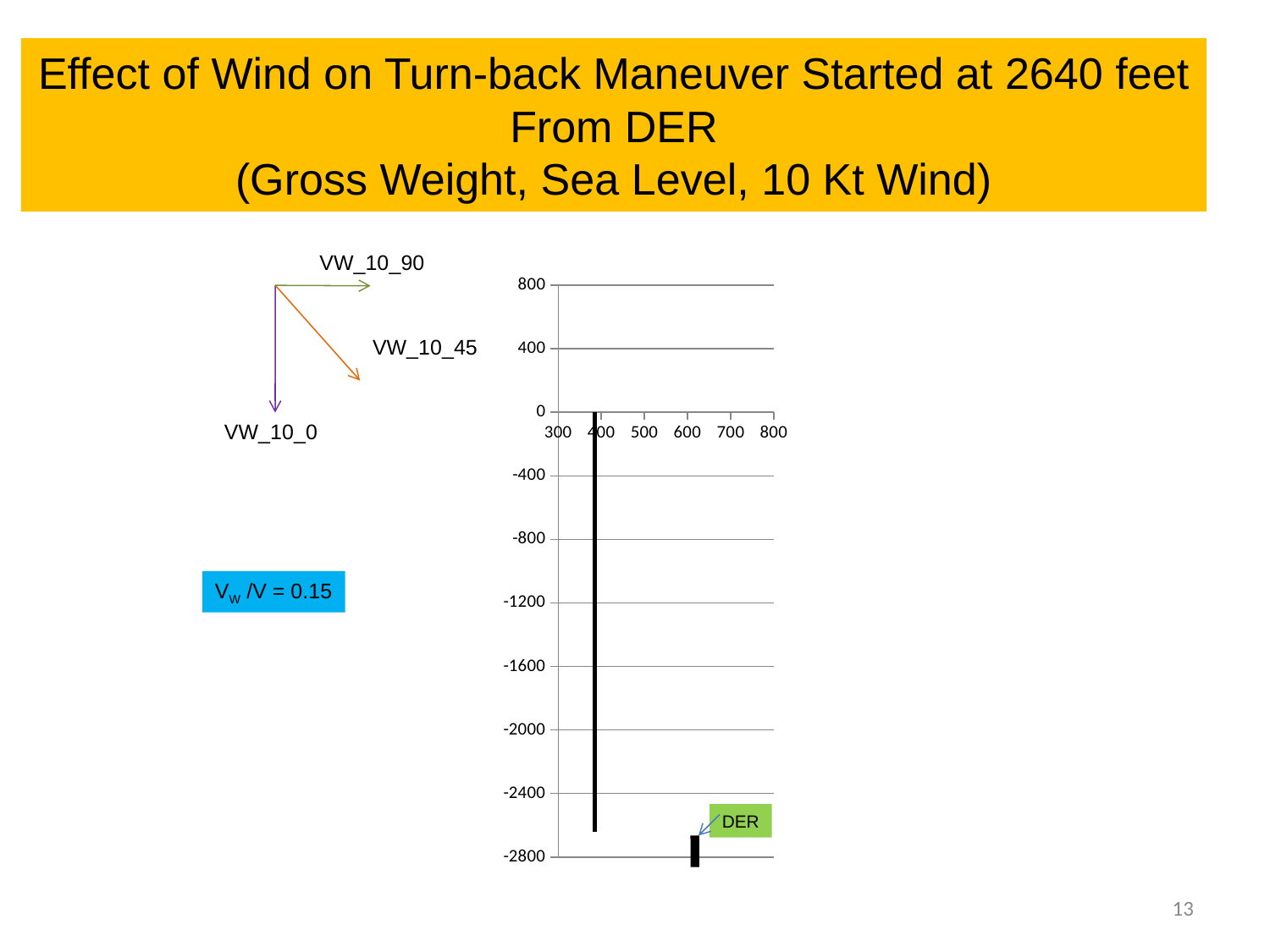
What is the highest value labelled on the vertical axis of the chart? 800 What is the spacing between consecutive gridlines on the vertical axis of the chart? 400 Is the lowest point of the tall vertical line in the chart greater or less than -2800? greater Is the horizontal position of the small bar labelled DER greater or less than 700? less What label is attached by an arrow to the small bar at the bottom right of the chart? DER What is the lowest value labelled on the vertical axis of the chart? -2800 How many tick labels are shown on the horizontal axis of the chart? 6 Is the horizontal position of the tall vertical line in the chart greater or less than 500? less What is the largest value labelled on the horizontal axis of the chart? 800 What is the smallest value labelled on the horizontal axis of the chart? 300